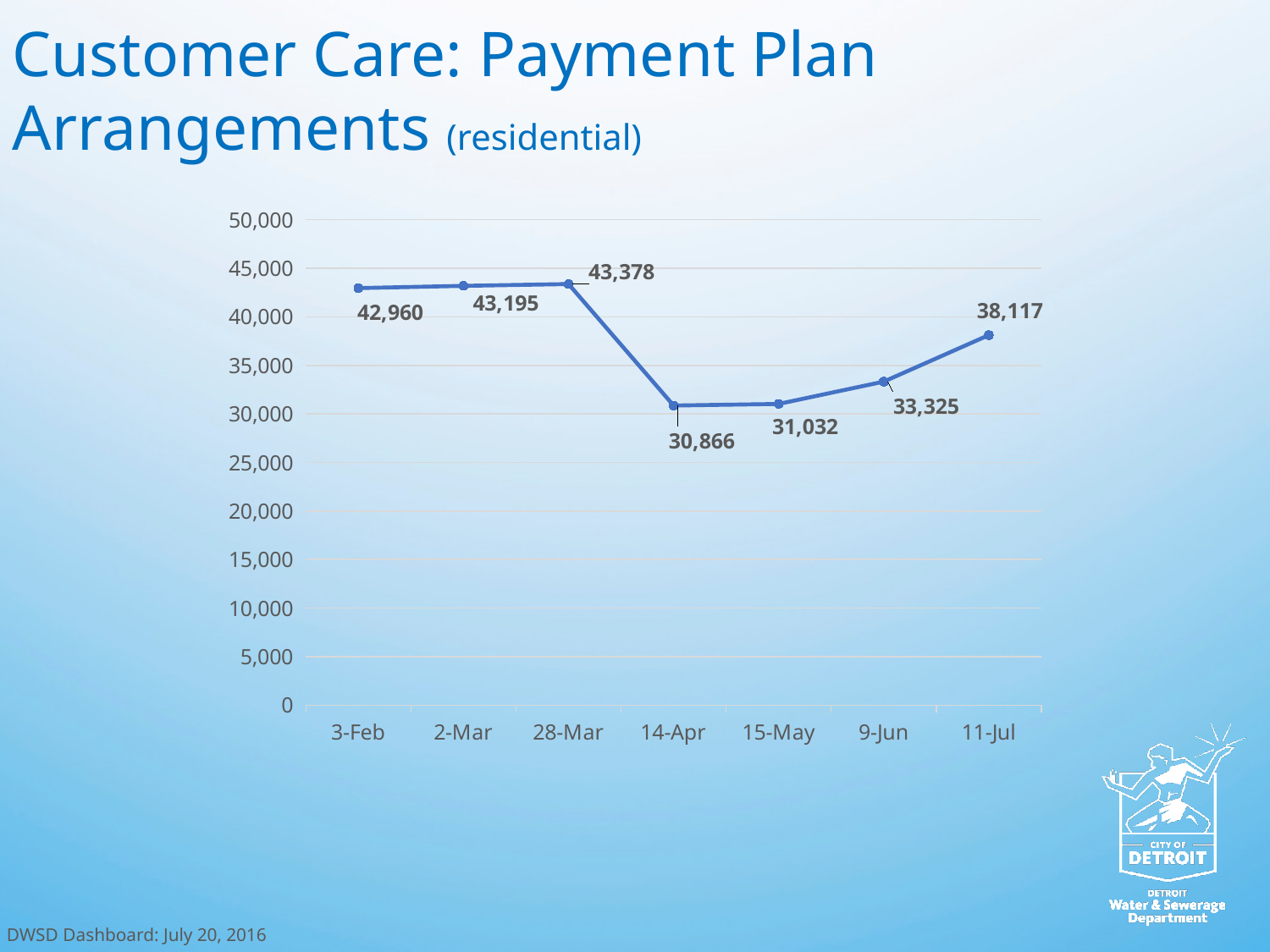
How many data points are plotted on the chart? 7 What kind of chart is shown on the slide? line chart What is the difference between the values for 28-Mar and 14-Apr? 12,512 What is the difference between the values for 11-Jul and 9-Jun? 4,792 What is the value for 3-Feb? 42,960 Which date has the lowest value? 14-Apr What is the value for 14-Apr? 30,866 Is the value for 9-Jun greater or less than 35,000? less What is the value for 11-Jul? 38,117 Do the values rise or fall from 14-Apr to 11-Jul? rise Which date has the highest value? 28-Mar Which is larger, the value for 2-Mar or the value for 15-May? 2-Mar